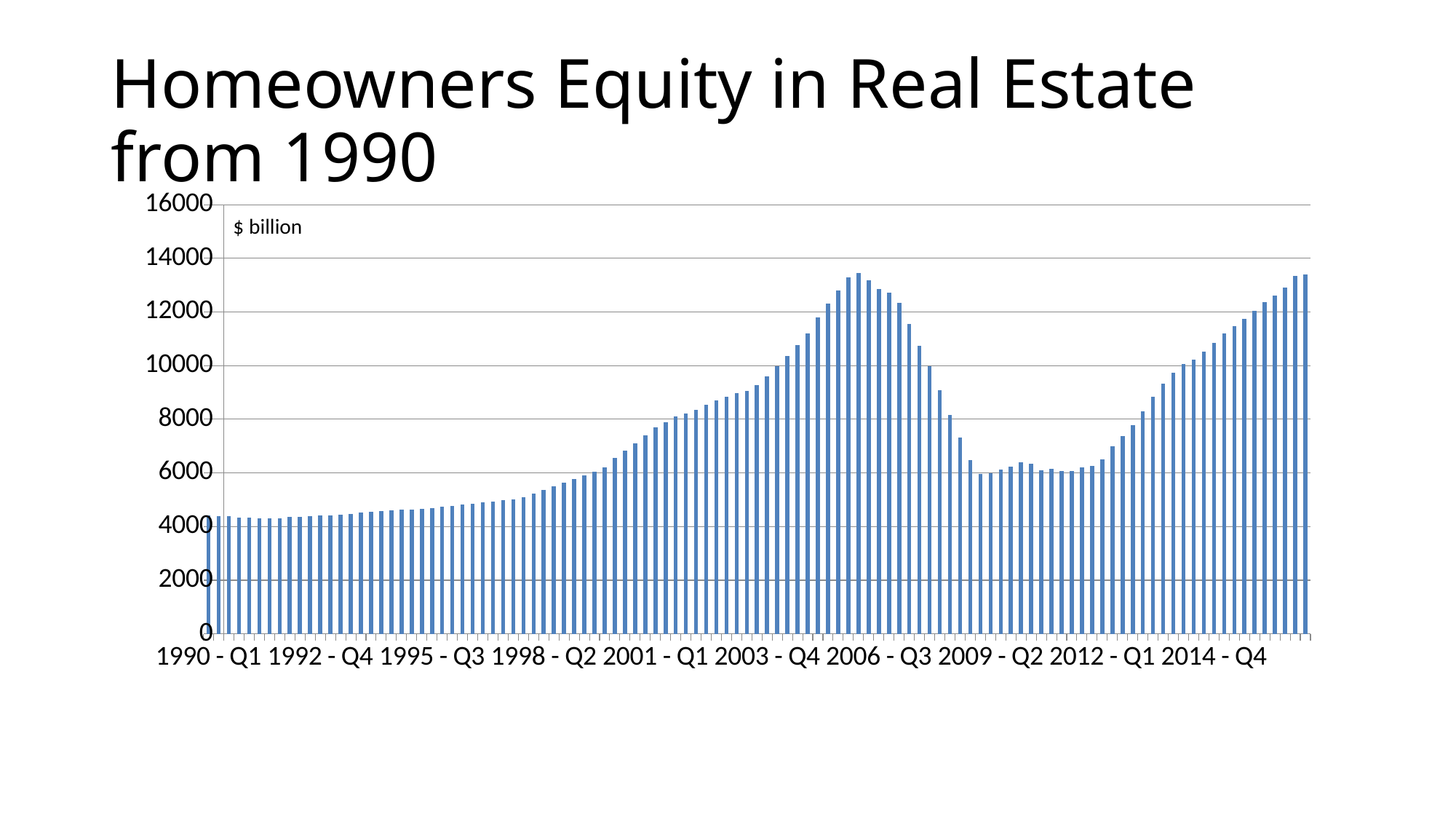
Do the values rise or fall between 2006 - Q3 and 2009 - Q2? fall Is the value for 2009 - Q2 greater or less than 8000? less Is the value for 2003 - Q4 greater or less than 8000? greater What is the title of the chart? Homeowners Equity in Real Estate from 1990 Is the value for 2014 - Q4 greater or less than 10000? greater What kind of chart is shown on the slide? bar chart Which is larger, the value for 2006 - Q3 or the value for 2009 - Q2? 2006 - Q3 What unit is indicated for the values on the chart? $ billion Which is larger, the value for 1990 - Q1 or the value for 2014 - Q4? 2014 - Q4